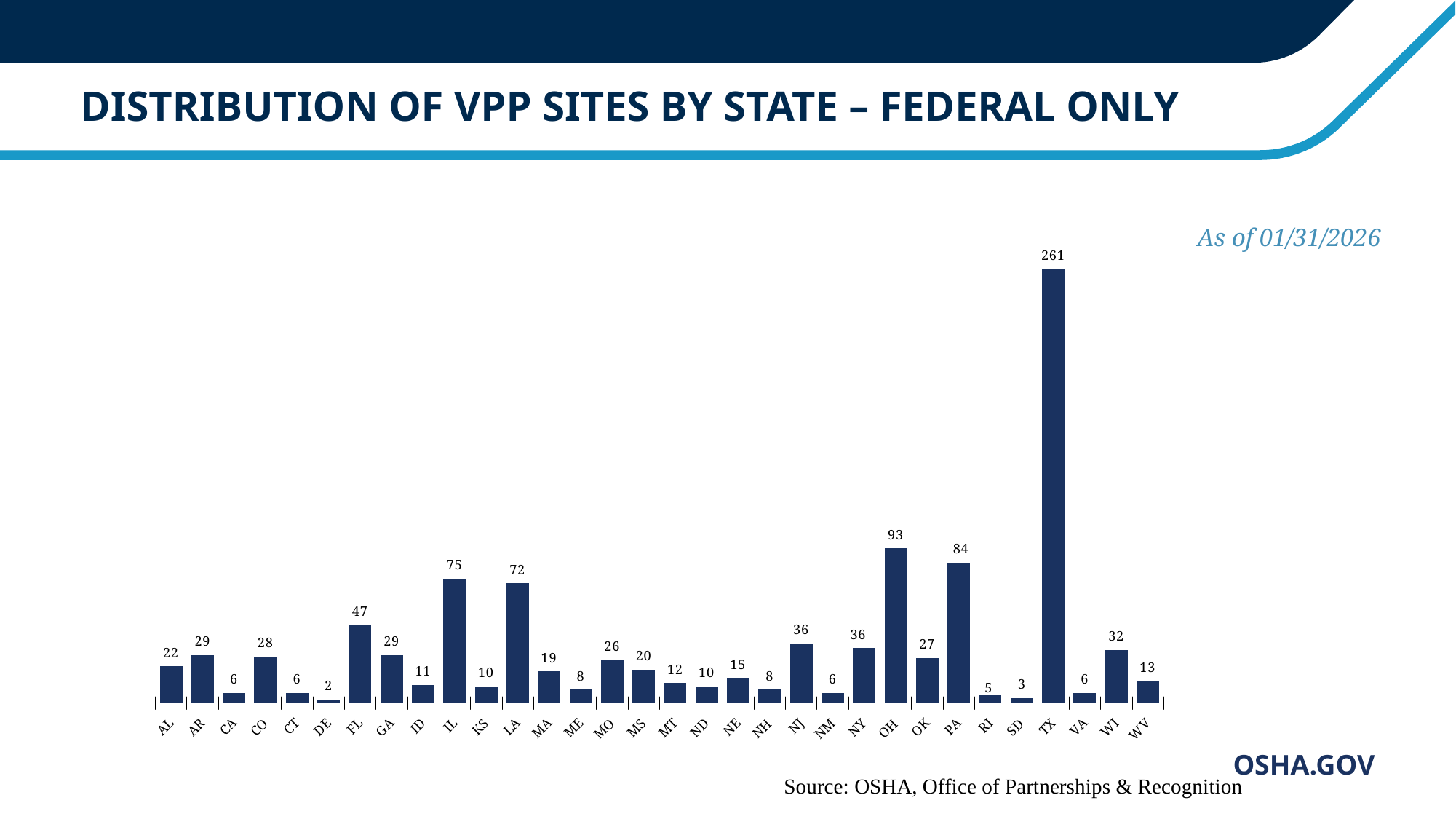
What kind of chart is shown on the slide? bar chart What is the difference between the values for OH and PA? 9 What is the value shown for IL? 75 What is the value shown for OH? 93 Which state has the highest number of VPP sites? TX What is the difference between the values for TX and OH? 168 What is the value shown for WV? 13 Which state has the lowest number of VPP sites? DE How many VPP sites does Texas (TX) have? 261 Which has a larger value, FL or WI? FL How many states are shown on the x axis? 32 What date is the data current as of, according to the slide? 01/31/2026